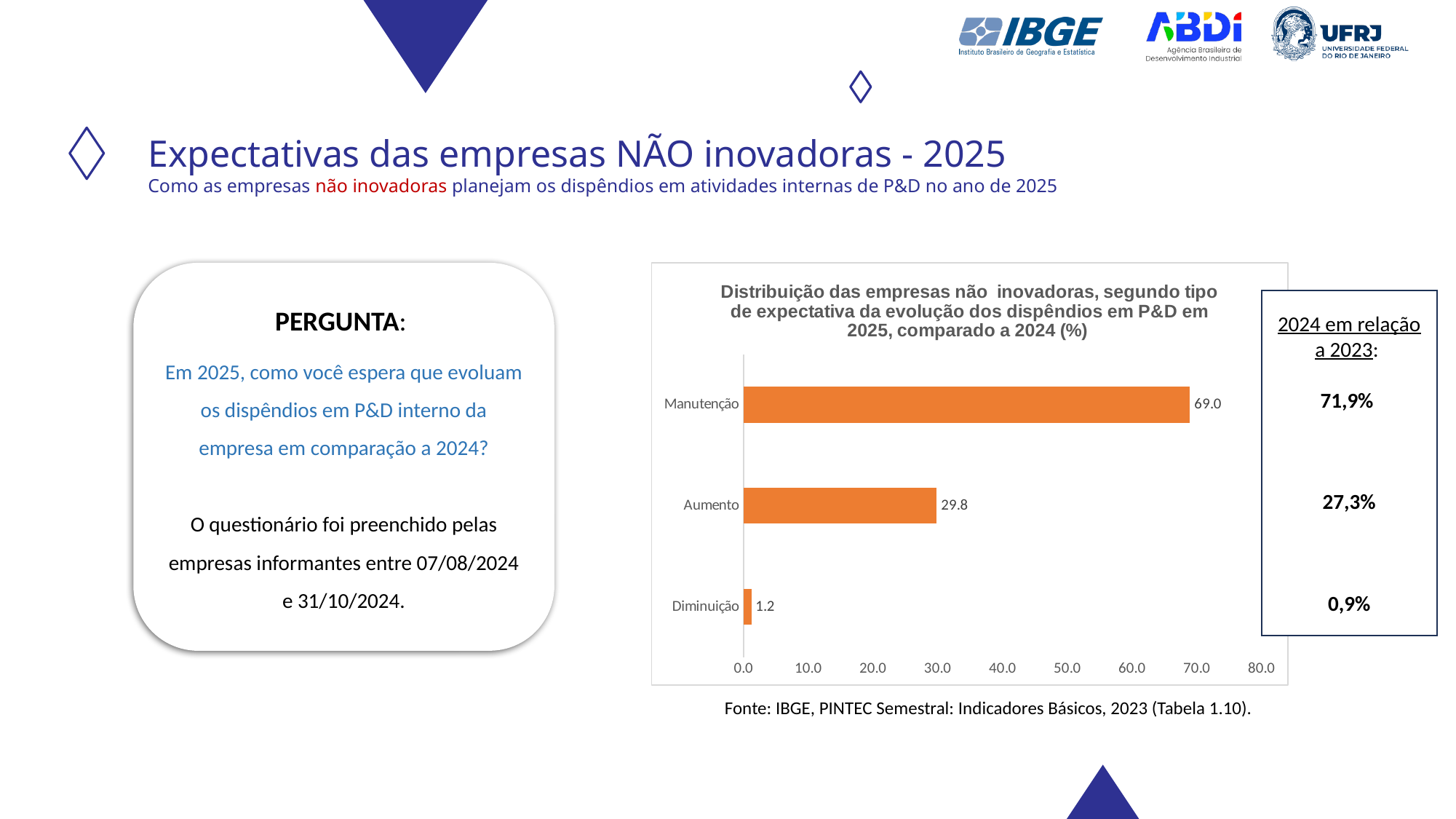
How many categories are shown in the chart? 3 What is the value for Aumento? 29.8 What is the difference between the values for Aumento and Diminuição? 28.6 What kind of chart is shown on the slide? bar chart What is the value for Manutenção? 69.0 Which category has the lowest value? Diminuição What is the value for Diminuição? 1.2 Which is larger, the value for Aumento or the value for Diminuição? Aumento What is the difference between the values for Manutenção and Aumento? 39.2 What colour are the bars in the chart? orange Is the value for Manutenção greater or less than 60.0? greater Which category has the highest value? Manutenção